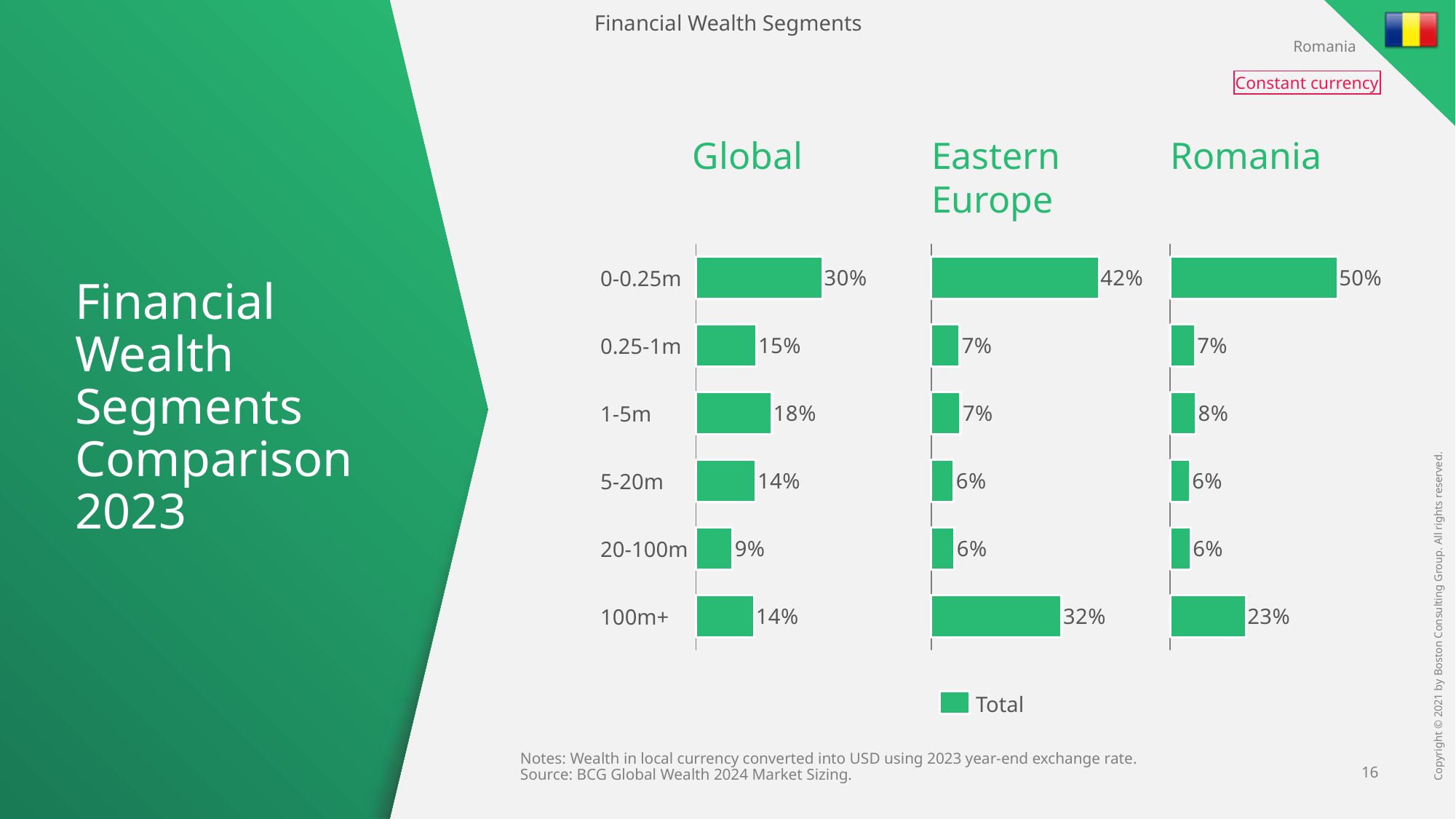
In the Eastern Europe chart, what is the value for the 100m+ segment? 32% In the Global chart, which segment has the lowest value? 20-100m In the Romania chart, what is the value for the 1-5m segment? 8% In the Global chart, what is the value for the 0-0.25m segment? 30% What is the difference between the 0-0.25m values in the Romania chart and the Global chart? 20 percentage points How many series does the legend list? 1 How many wealth segments are shown in each chart? 6 Which is larger: the 100m+ value in the Eastern Europe chart or in the Romania chart? Eastern Europe What is the legend entry shown below the charts? Total In the Eastern Europe chart, what is the difference between the 0-0.25m and 100m+ values? 10 percentage points In the Romania chart, which segment has the highest value? 0-0.25m What type of chart is used to show the Financial Wealth Segments? Bar chart